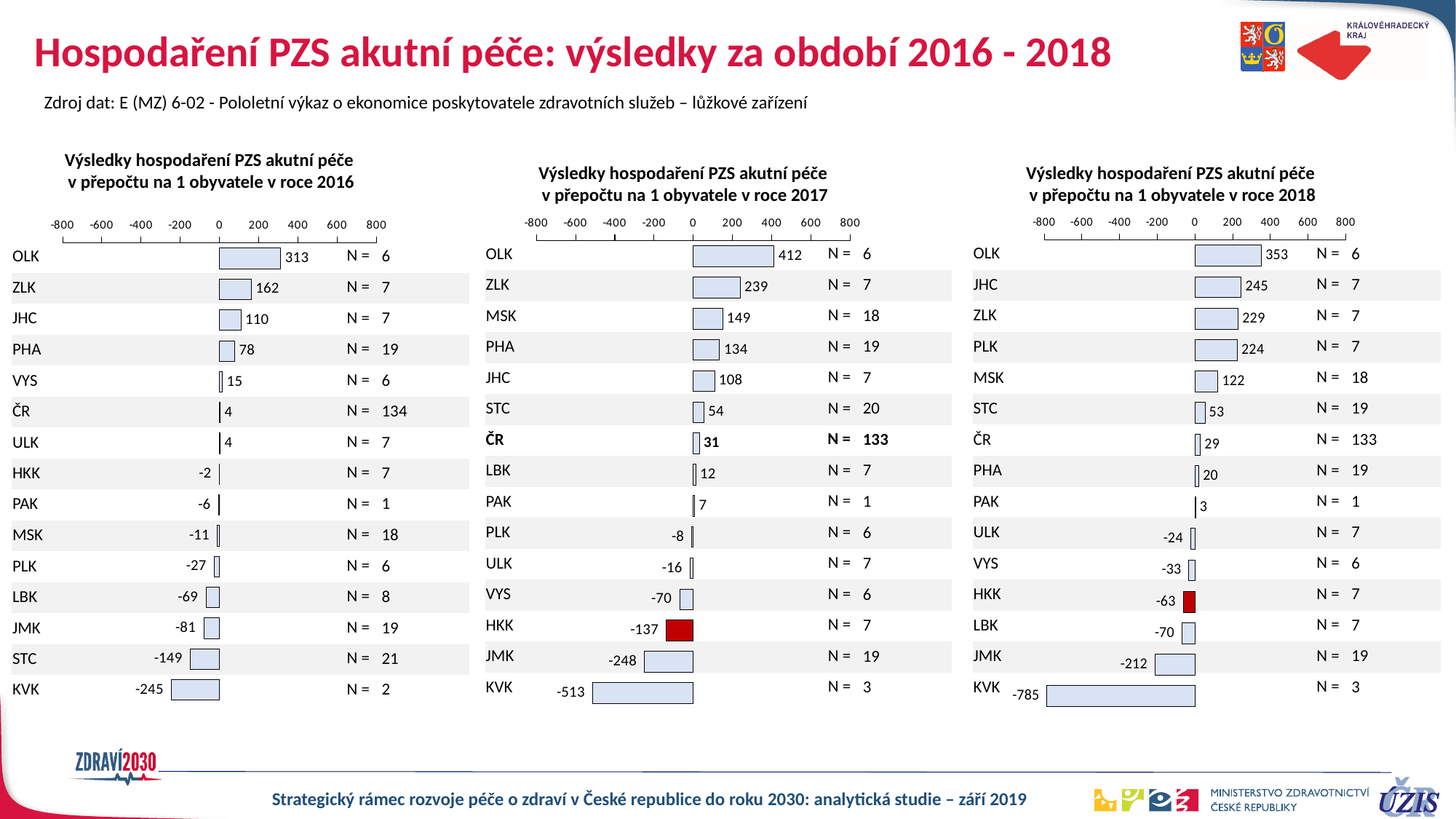
In the 2018 chart (right), which category's bar is coloured red? HKK What kind of chart is the 2017 chart (middle)? bar chart In the 2018 chart (right), what is the value for HKK? -63 In the 2017 chart (middle), which category has the highest value? OLK How many categories are shown in the 2016 chart (left)? 15 In the 2018 chart (right), which is larger, the value for JHC or the value for ZLK? JHC In the 2016 chart (left), what is the difference between the values for OLK and ZLK? 151 In the 2018 chart (right), which category has the lowest value? KVK In the 2017 chart (middle), is the value for OLK greater or less than 400? greater In the 2016 chart (left), what is the value for OLK? 313 In the 2017 chart (middle), what is the N value shown for ČR? 133 In the 2017 chart (middle), what is the value for KVK? -513